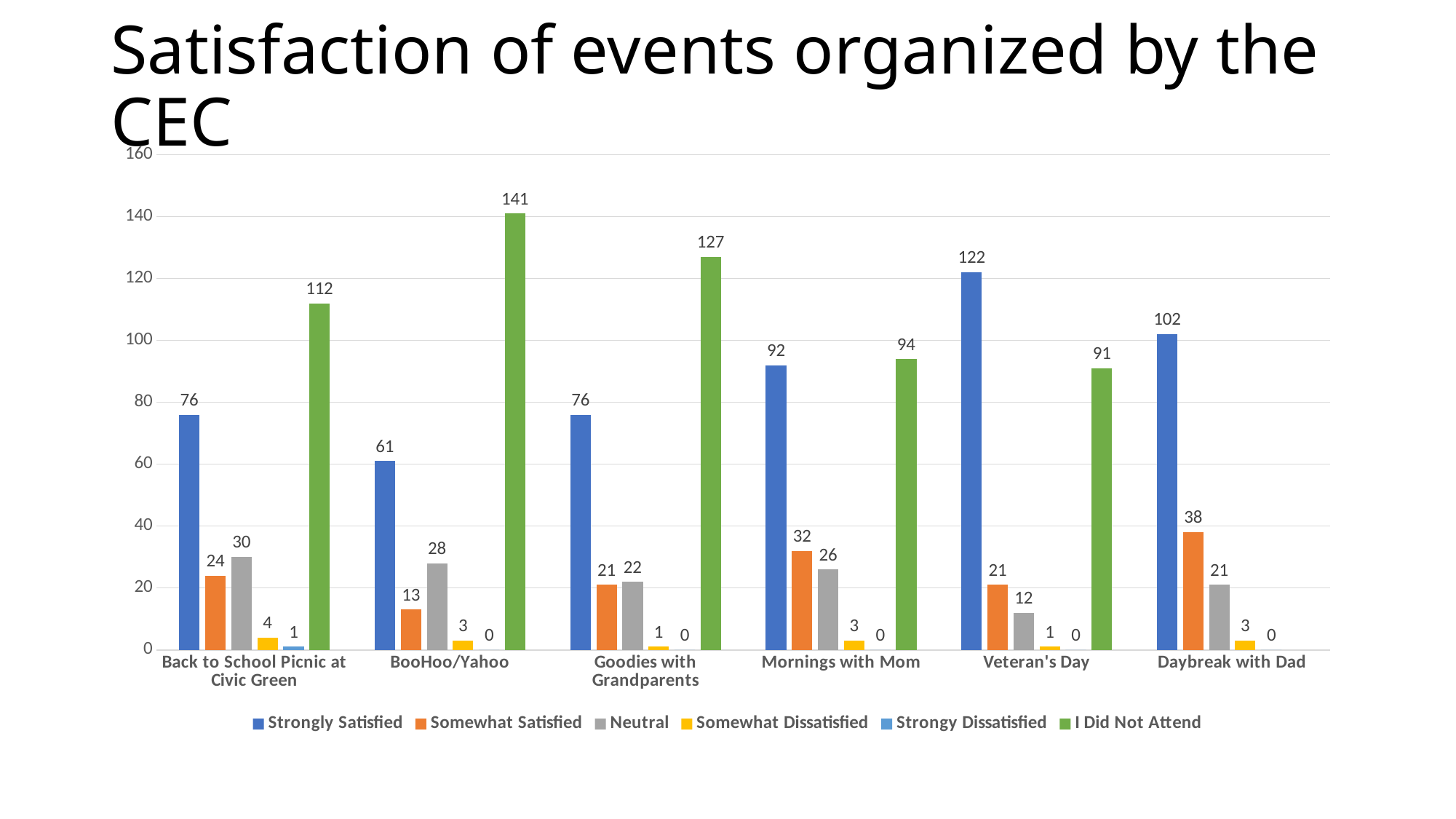
What is the Somewhat Satisfied value for Daybreak with Dad? 38 Which event has the lowest Neutral value? Veteran's Day What kind of chart is shown on the slide? Bar chart Which event has the highest Strongly Satisfied value? Veteran's Day How many series does the legend list? 6 Which is larger for Mornings with Mom: Strongly Satisfied or I Did Not Attend? I Did Not Attend What is the Neutral value for Mornings with Mom? 26 How many events are shown on the x axis? 6 What is the difference between the I Did Not Attend values for BooHoo/Yahoo and Goodies with Grandparents? 14 What is the Strongly Satisfied value for Veteran's Day? 122 What is the I Did Not Attend value for BooHoo/Yahoo? 141 What colour are the I Did Not Attend bars? Green